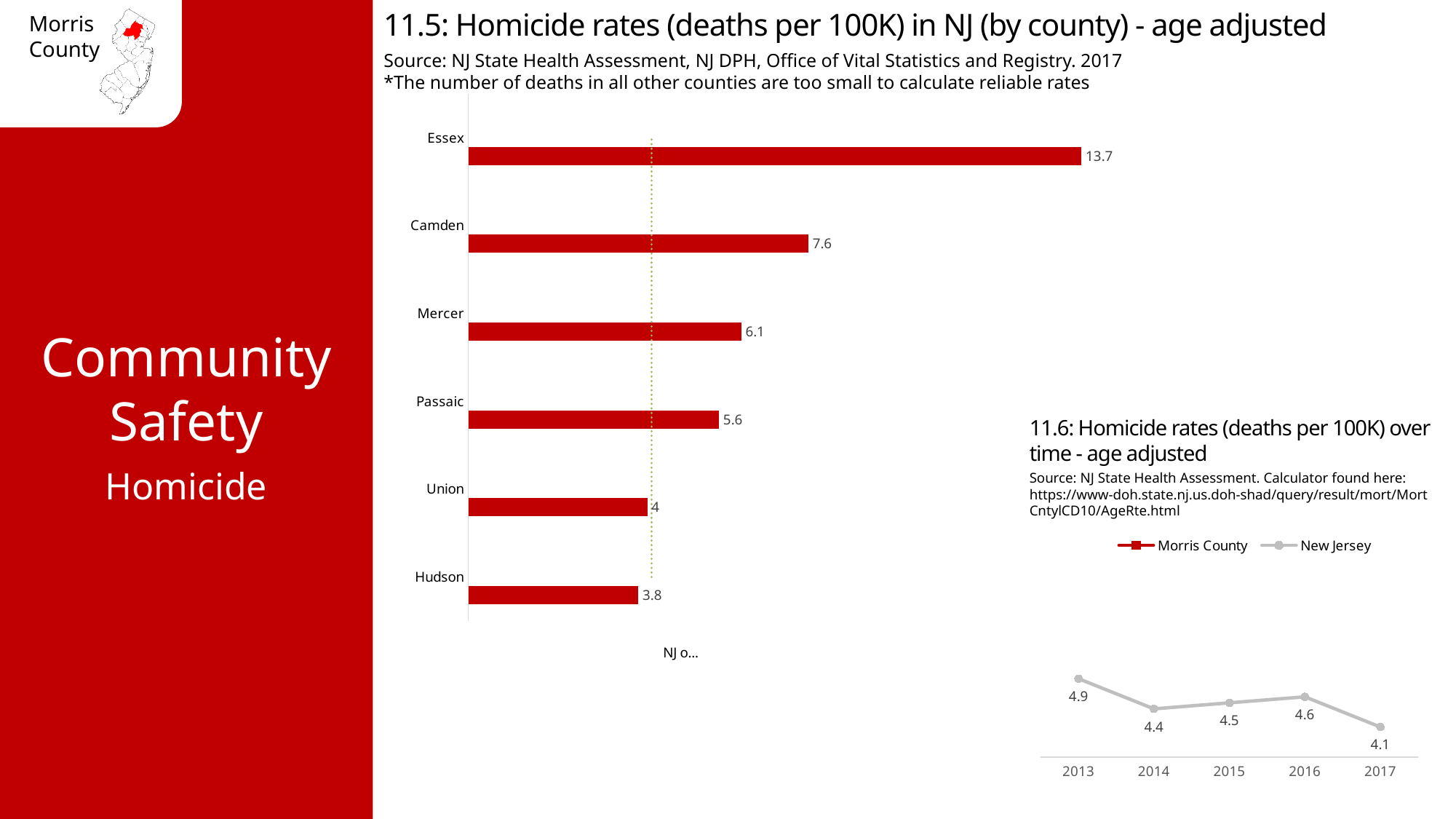
In chart 11.5 (Homicide rates in NJ by county), what is the homicide rate for Essex? 13.7 In chart 11.5 (Homicide rates in NJ by county), which county has the lowest homicide rate? Hudson In chart 11.5 (Homicide rates in NJ by county), which county has the highest homicide rate? Essex In chart 11.5 (Homicide rates in NJ by county), which county has a higher homicide rate, Mercer or Union? Mercer In chart 11.6 (Homicide rates over time), how many series does the legend list? 2 In chart 11.5 (Homicide rates in NJ by county), what is the difference between the rates for Essex and Camden? 6.1 In chart 11.5 (Homicide rates in NJ by county), how many counties are shown? 6 In chart 11.6 (Homicide rates over time), what is the New Jersey homicide rate in 2013? 4.9 In chart 11.6 (Homicide rates over time), which year has the lowest New Jersey homicide rate? 2017 In chart 11.5 (Homicide rates in NJ by county), what is the homicide rate for Passaic? 5.6 In chart 11.6 (Homicide rates over time), what is the New Jersey homicide rate in 2017? 4.1 What kind of chart is chart 11.5 (Homicide rates in NJ by county)? Bar chart